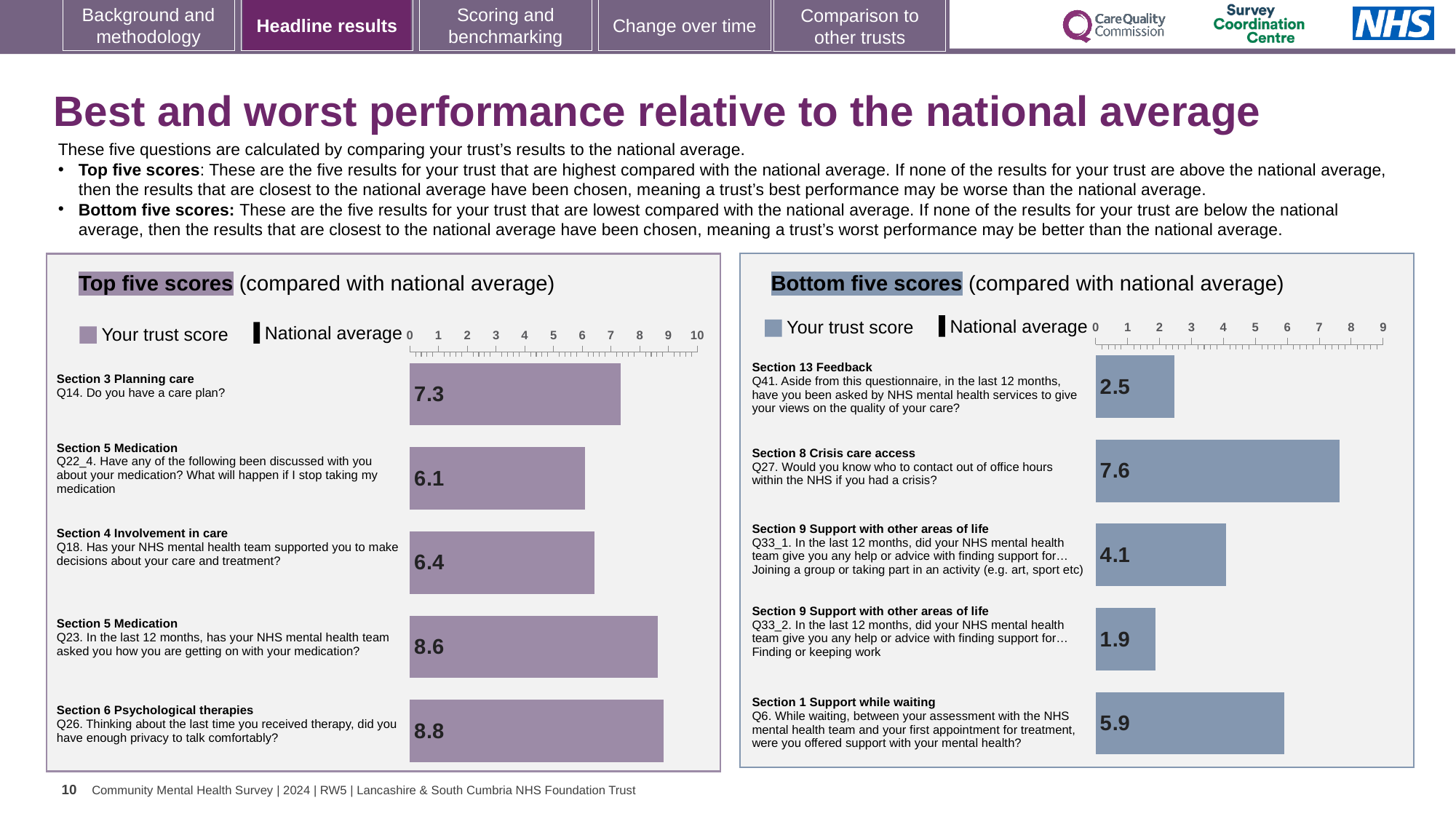
In the Top five scores chart, what is the difference between the scores for Q26 and Q14? 1.5 In the Bottom five scores chart, which has the larger score: Q41 (asked for your views on quality of care) or Q33_1 (joining a group or activity)? Q33_1 (4.1) In the Bottom five scores chart, what is the difference between the scores for Q27 and Q6? 1.7 In the Bottom five scores chart, which question has the lowest trust score? Q33_2 (finding or keeping work), 1.9 In the Top five scores chart, which question has the highest trust score? Q26 (Section 6 Psychological therapies), 8.8 How many entries does the legend of the Bottom five scores chart list? 2 In the Top five scores chart, is the score for Q23 greater or less than 8? greater How many bars are plotted in the Bottom five scores chart? 5 What is the highest tick value shown on the axis of the Top five scores chart? 10 What type of chart is used for the Top five scores? bar chart In the Bottom five scores chart, what is the trust score for Q27 about knowing who to contact out of office hours in a crisis? 7.6 In the Top five scores chart, what is the trust score for Q14 'Do you have a care plan?' 7.3